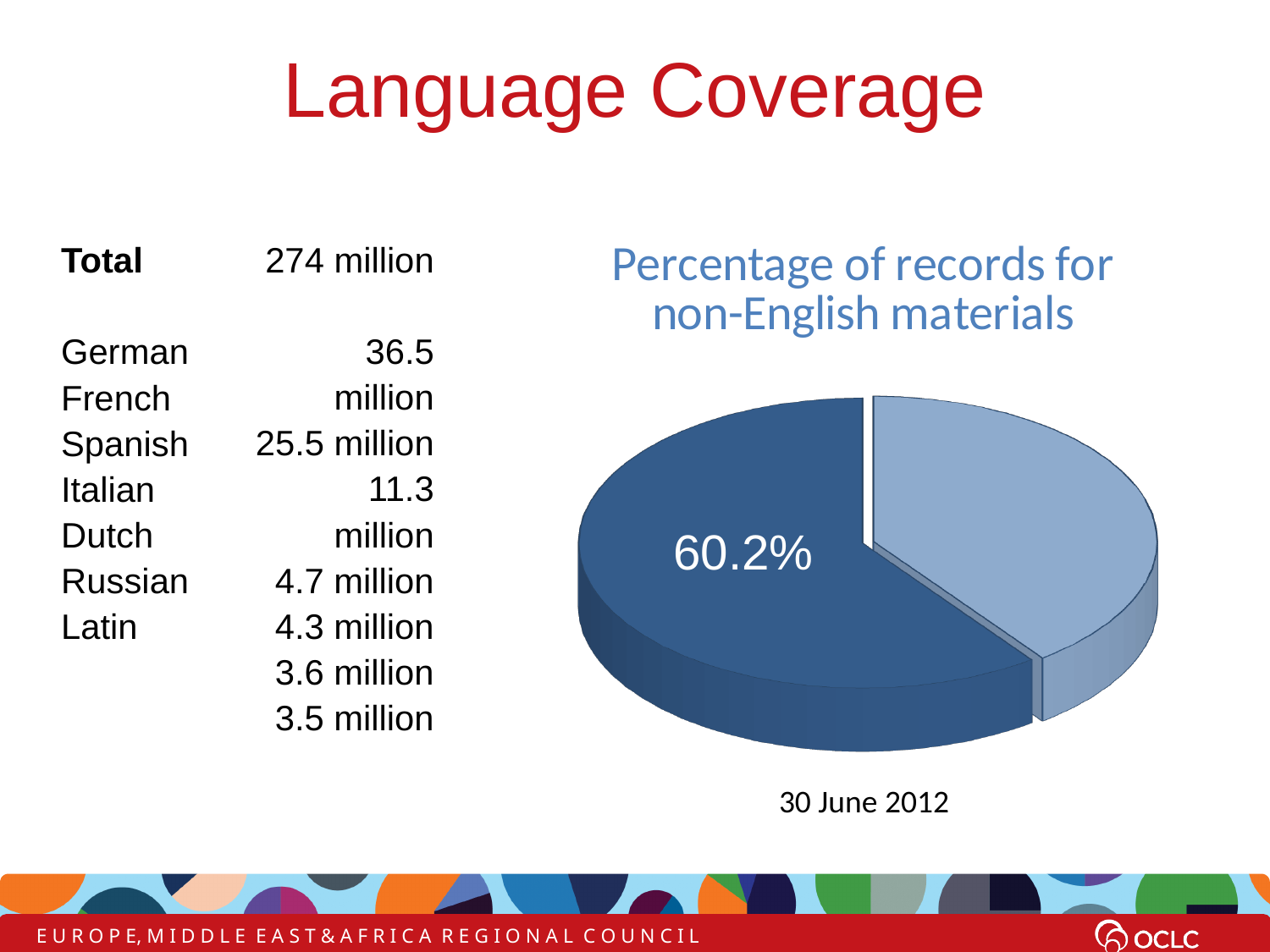
Is the share of the dark blue slice of the pie chart greater or less than 50%? greater What is the title of the pie chart? Percentage of records for non-English materials How many slices does the pie chart have? 2 What date is shown beneath the pie chart? 30 June 2012 What kind of chart is shown on the slide? pie chart Which slice of the pie chart is larger, the dark blue slice or the light blue slice? the dark blue slice Is the share of the light blue slice of the pie chart greater or less than 50%? less What percentage is printed on the dark blue slice of the pie chart? 60.2%